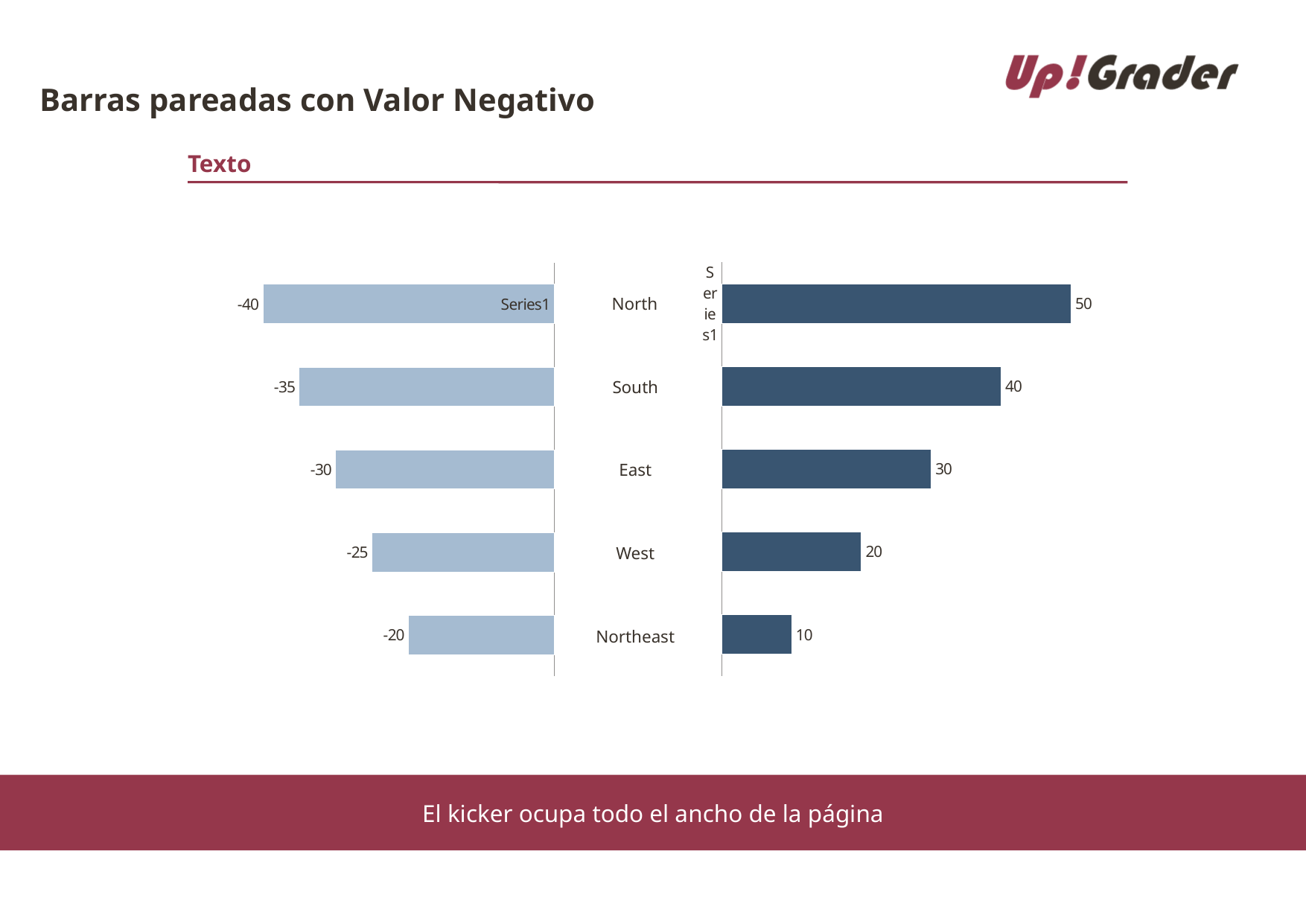
In the right chart, which category has the highest value? North In the left chart, which category has the lowest (most negative) value? North In the right chart, which is larger, the value for South or the value for West? South In the left chart, what is the value for West? -25 In the right chart, what is the difference between the values for North and East? 20 How many categories are shown in the right chart? 5 What kind of chart is shown on the slide? Bar chart In the right chart, what is the value for North? 50 In the right chart, which category has the lowest value? Northeast In the right chart, what is the value for Northeast? 10 In the right chart, do the values rise or fall going from North down to Northeast? Fall In the left chart, what is the value for South? -35